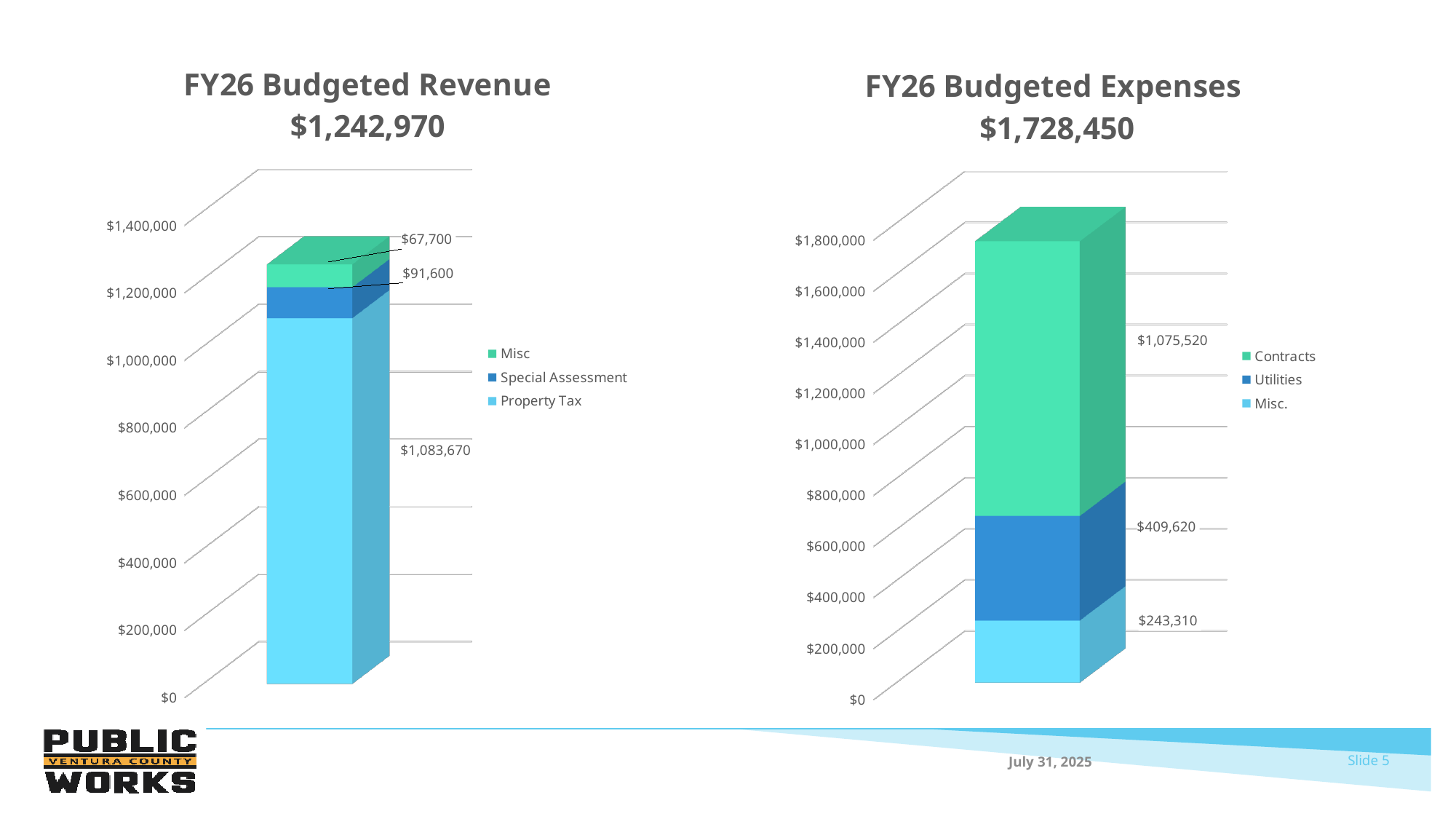
In the FY26 Budgeted Expenses chart, what is the difference between Contracts and Utilities? $665,900 In the FY26 Budgeted Expenses chart, which colour represents Contracts? Green In the FY26 Budgeted Revenue chart, which series has the largest value? Property Tax In the FY26 Budgeted Expenses chart, which series has the smallest value? Misc. In the FY26 Budgeted Revenue chart, what is the value for Property Tax? $1,083,670 In the FY26 Budgeted Expenses chart, what is the value for Contracts? $1,075,520 In the FY26 Budgeted Revenue chart, which is larger, Misc or Special Assessment? Special Assessment In the FY26 Budgeted Revenue chart, what is the value for Special Assessment? $91,600 In the FY26 Budgeted Expenses chart, what is the value for Utilities? $409,620 How many series does the legend of the FY26 Budgeted Revenue chart list? 3 What is the total of the stacked bar in the FY26 Budgeted Expenses chart? $1,728,450 What kind of chart is the FY26 Budgeted Expenses chart? Stacked bar chart